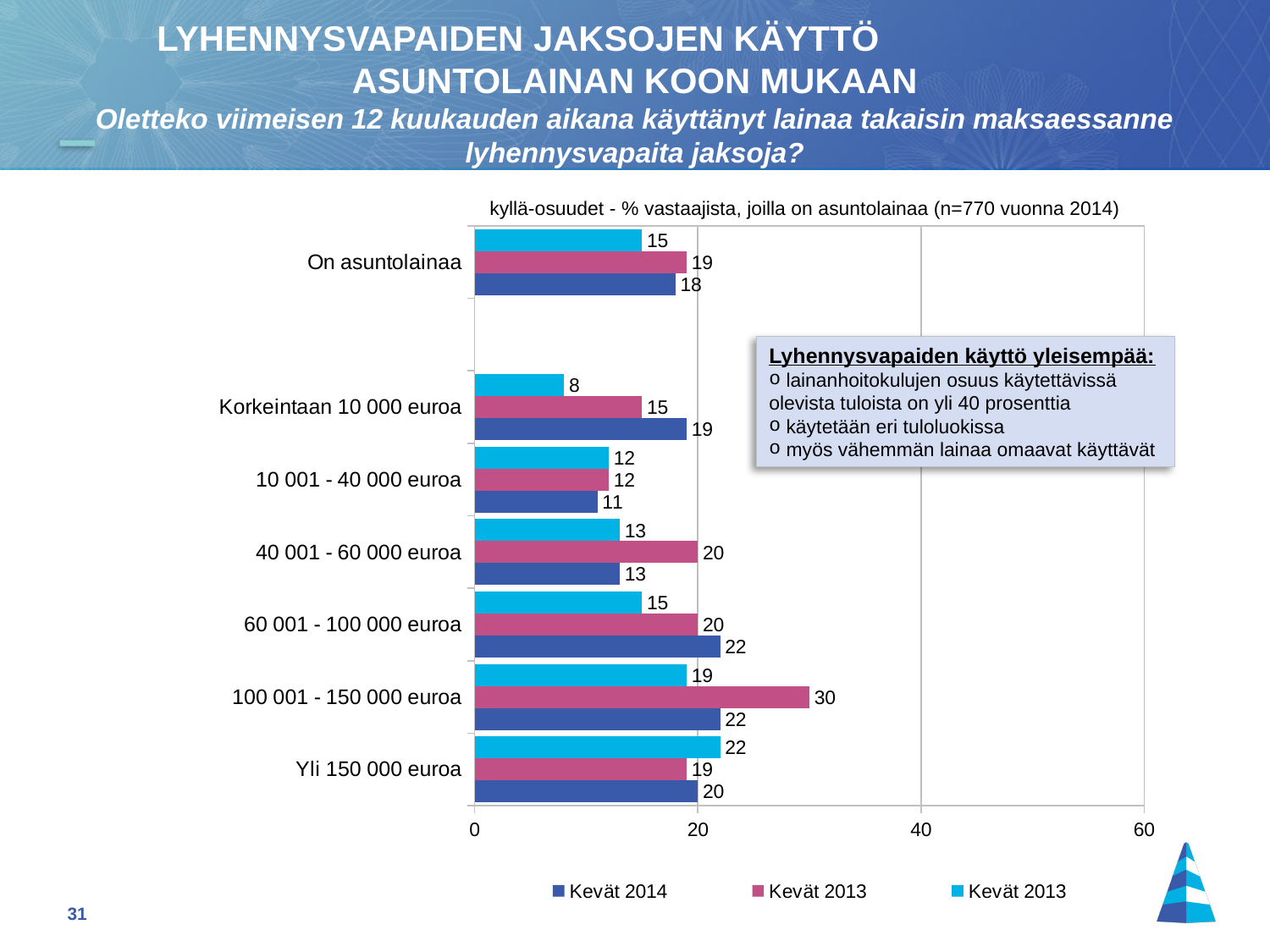
How many series does the legend list? 3 What is the value of the light blue bar for 'Korkeintaan 10 000 euroa'? 8 What is the difference between the Kevät 2014 values for '60 001 - 100 000 euroa' and '40 001 - 60 000 euroa'? 9 What is the value of the pink bar for '100 001 - 150 000 euroa'? 30 Which category has the highest value for the pink series? 100 001 - 150 000 euroa Which is larger: the Kevät 2014 value for 'Korkeintaan 10 000 euroa' or for '10 001 - 40 000 euroa'? Korkeintaan 10 000 euroa How many loan-size categories are shown on the chart? 6 What is the Kevät 2014 value for '60 001 - 100 000 euroa'? 22 What type of chart is shown on the slide? bar chart What is the maximum value shown on the x axis? 60 What is the Kevät 2014 value for 'On asuntolainaa'? 18 Which category has the lowest Kevät 2014 value? 10 001 - 40 000 euroa